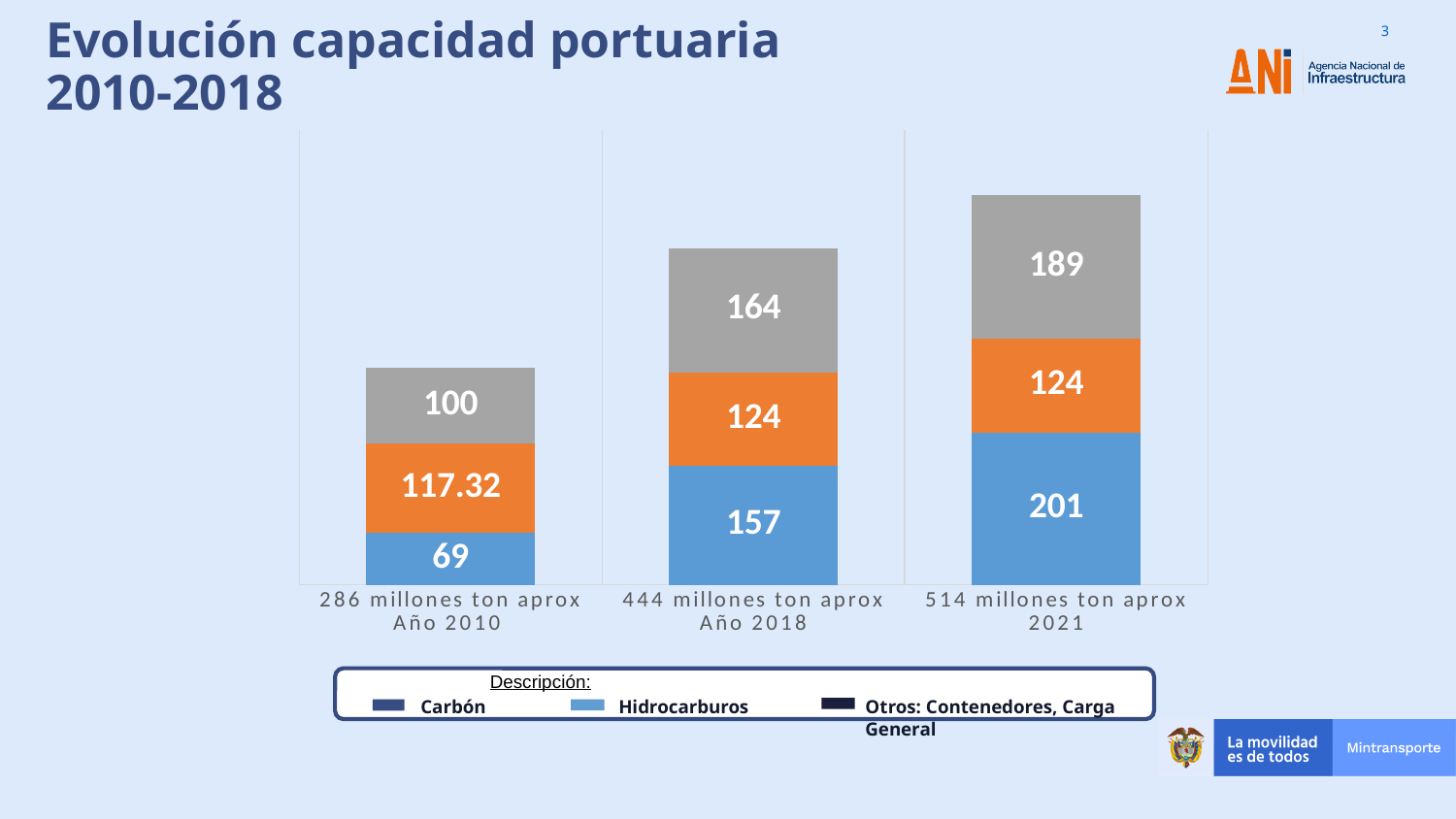
Which bar has the largest bottom (blue) segment? 2021 What kind of chart is shown on the slide? Stacked bar chart How many stacked bars does the chart show? 3 Do the values of the bottom (blue) segments rise or fall from the 2010 bar to the 2021 bar? Rise What is the value of the middle (orange) segment of the Año 2010 bar? 117.32 Which is larger: the gray segment of the Año 2018 bar or the gray segment of the 2021 bar? 2021 How many series does the legend list? 3 What is the total of the 2021 stacked bar? 514 What is the value of the bottom (blue) segment of the 2021 bar? 201 What is the value of the top (gray) segment of the Año 2018 bar? 164 What is the value of the bottom (blue) segment of the Año 2010 bar? 69 What is the difference between the blue segment of the 2021 bar and the blue segment of the Año 2018 bar? 44